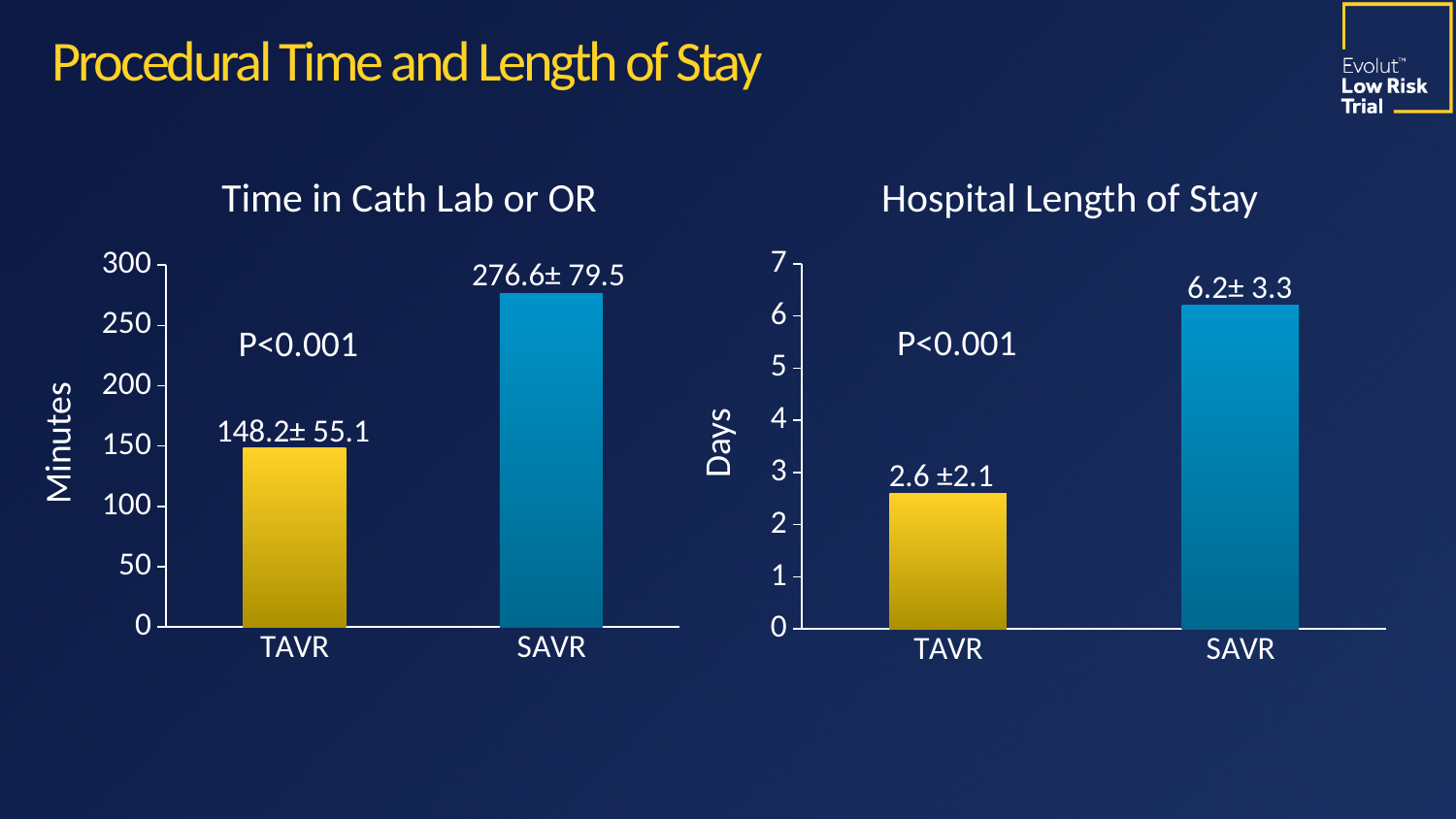
In the 'Hospital Length of Stay' chart, what is the difference between the SAVR and TAVR mean stays in days? 3.6 In the 'Time in Cath Lab or OR' chart, is the mean value for SAVR greater or less than 250? greater What type of chart is the 'Time in Cath Lab or OR' chart? bar chart In the 'Time in Cath Lab or OR' chart, what value is labelled on the SAVR bar? 276.6± 79.5 In the 'Time in Cath Lab or OR' chart, which group has the higher mean time? SAVR How many bars are shown in the 'Hospital Length of Stay' chart? 2 In the 'Hospital Length of Stay' chart, which group has the shorter mean stay? TAVR In the 'Hospital Length of Stay' chart, what value is labelled on the TAVR bar? 2.6 ±2.1 In the 'Hospital Length of Stay' chart, what value is labelled on the SAVR bar? 6.2± 3.3 In the 'Time in Cath Lab or OR' chart, what value is labelled on the TAVR bar? 148.2± 55.1 What is the y-axis label of the 'Hospital Length of Stay' chart? Days In the 'Time in Cath Lab or OR' chart, what is the difference between the SAVR and TAVR mean times in minutes? 128.4